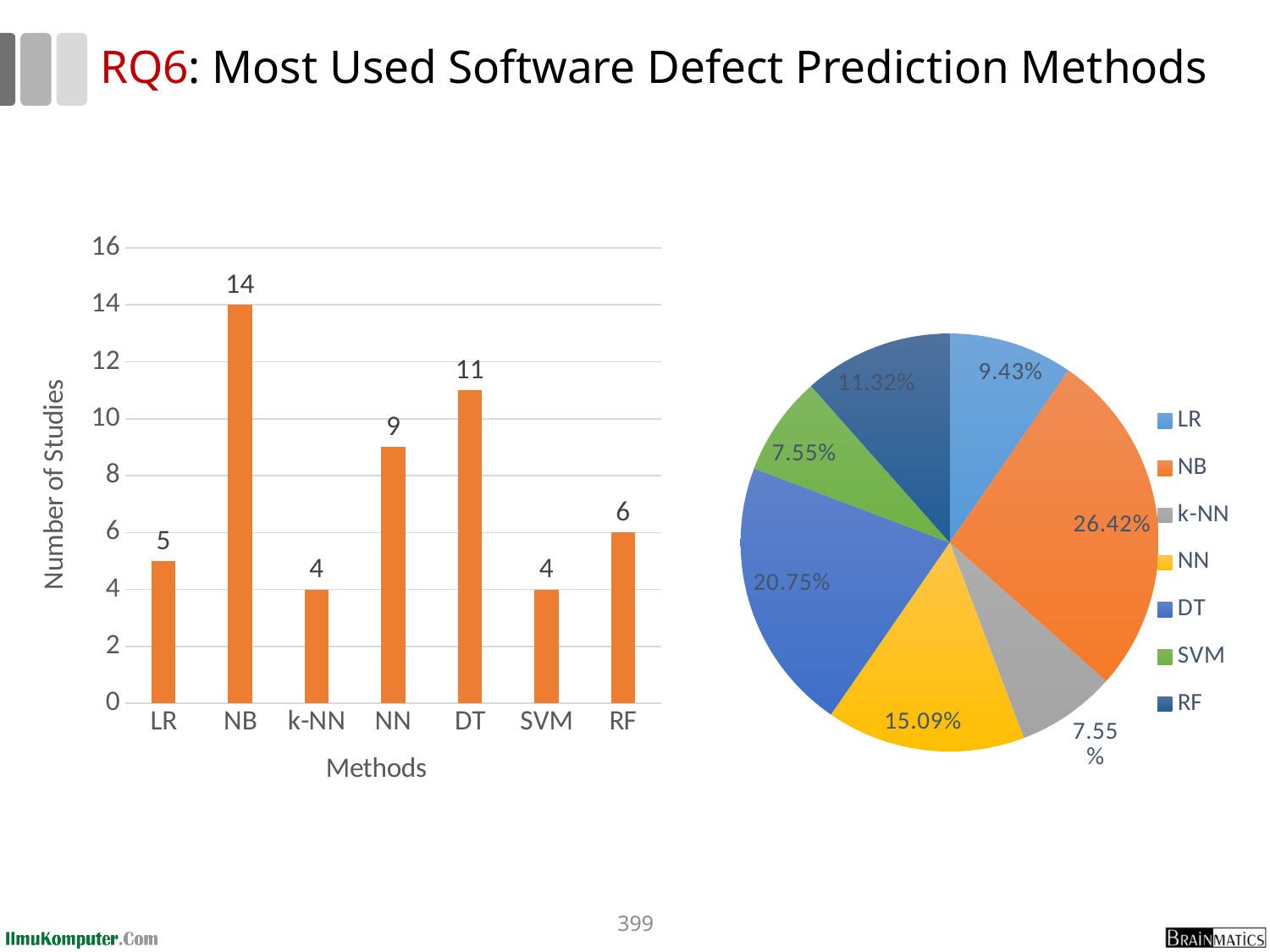
In the bar chart on the left, what is the difference in number of studies between NB and NN? 5 In the pie chart on the right, what share does NB have? 26.42% In the pie chart on the right, what share does DT have? 20.75% In the bar chart on the left, what is the number of studies for DT? 11 In the bar chart on the left, which method has the highest number of studies? NB In the pie chart on the right, how many entries does the legend list? 7 In the pie chart on the right, which method has the largest slice? NB What is the label of the y axis of the bar chart on the left? Number of Studies In the bar chart on the left, how many methods are shown on the x axis? 7 In the bar chart on the left, what is the number of studies for NB? 14 What kind of chart is the chart on the left? bar chart In the bar chart on the left, which has more studies, RF or LR? RF